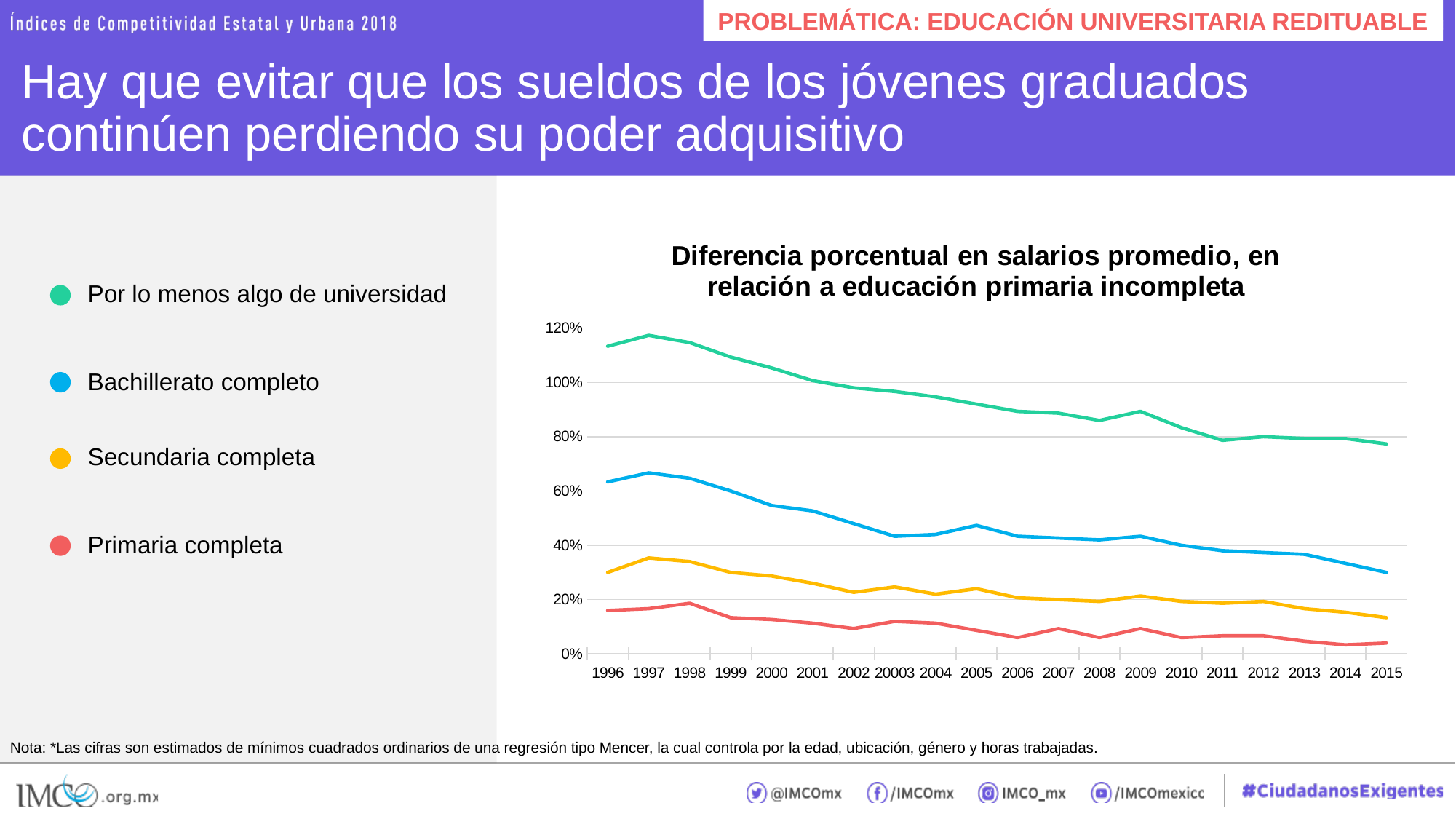
Is the value for Por lo menos algo de universidad in 2015 greater or less than 80%? less Is the value for Primaria completa in 2015 greater or less than 20%? less How many years are plotted along the x axis? 20 How many series does the legend list? 4 Which series has the highest values across the chart? Por lo menos algo de universidad Does the value for Por lo menos algo de universidad rise or fall from 1996 to 2015? fall What kind of chart is shown on the slide? line chart Is the value for Por lo menos algo de universidad in 1996 greater or less than 100%? greater What is the title of the chart? Diferencia porcentual en salarios promedio, en relación a educación primaria incompleta In 2015, which is larger: the value for Bachillerato completo or the value for Secundaria completa? Bachillerato completo Which series has the lowest values across the chart? Primaria completa